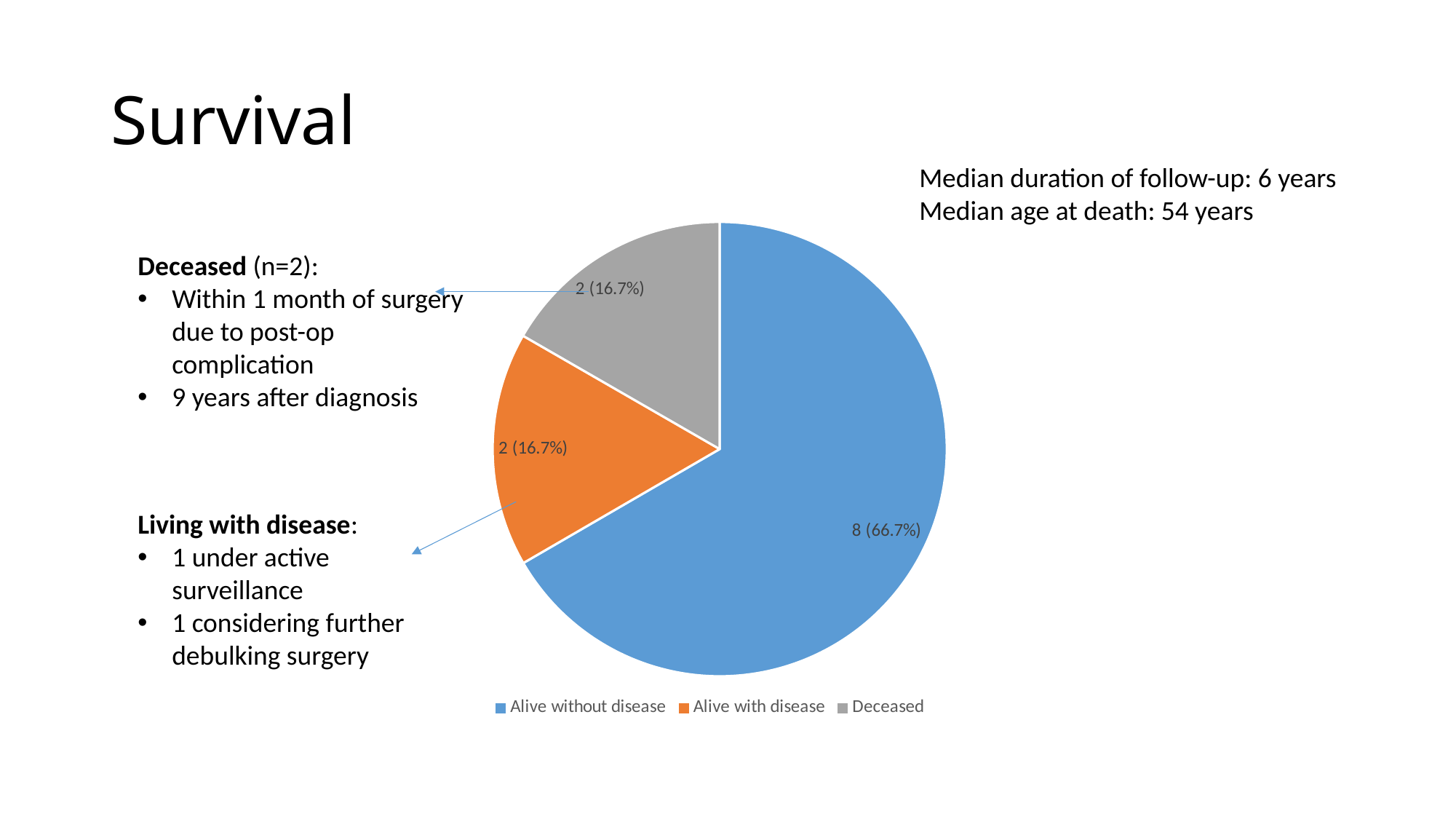
How many categories does the pie chart show? 3 Which category has the largest slice of the pie? Alive without disease Which is larger: the Alive without disease slice or the Alive with disease slice? Alive without disease What is the total number of patients represented in the pie chart? 12 How many entries does the legend list? 3 How many patients are alive with disease according to the pie chart? 2 What kind of chart is shown on the slide? pie chart What share of the pie does the Deceased slice represent? 16.7% What is the difference between the number of patients alive without disease and the number deceased? 6 What share of the pie does the Alive without disease slice represent? 66.7% What colour is the Deceased slice in the pie chart? grey How many patients are alive without disease according to the pie chart? 8